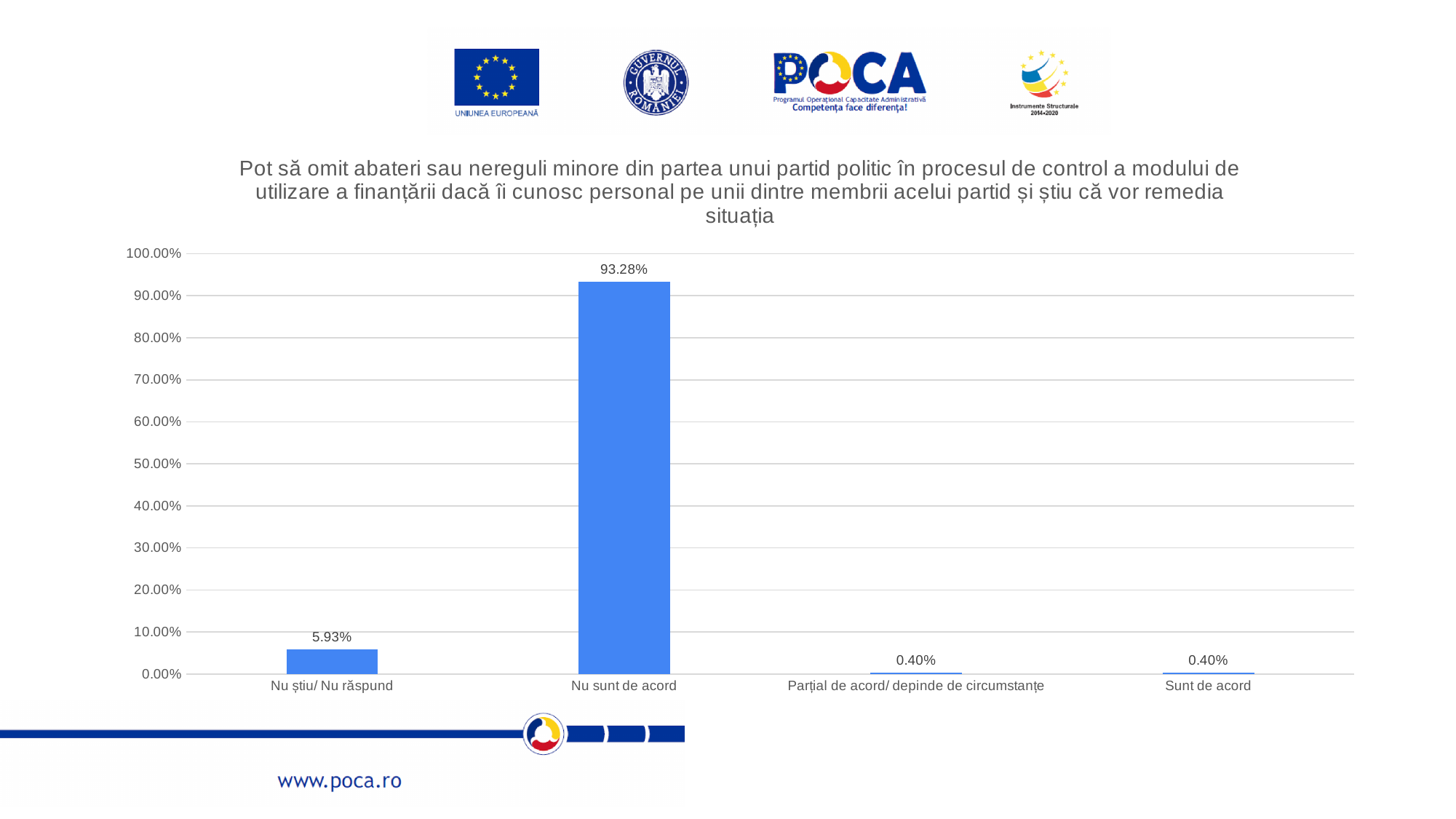
Is the value for "Nu știu/ Nu răspund" greater or less than 10.00%? less Is the value for "Nu sunt de acord" greater or less than 90.00%? greater What is the value for "Nu sunt de acord"? 93.28% What is the value for "Parțial de acord/ depinde de circumstanțe"? 0.40% Which category has the highest value? Nu sunt de acord What is the value for "Nu știu/ Nu răspund"? 5.93% Which is larger, the value for "Nu știu/ Nu răspund" or the value for "Sunt de acord"? Nu știu/ Nu răspund What is the highest value shown on the y axis? 100.00% How many categories are shown on the x axis? 4 What kind of chart is shown on the slide? bar chart What is the value for "Sunt de acord"? 0.40% What is the difference between the values for "Nu sunt de acord" and "Nu știu/ Nu răspund"? 87.35%